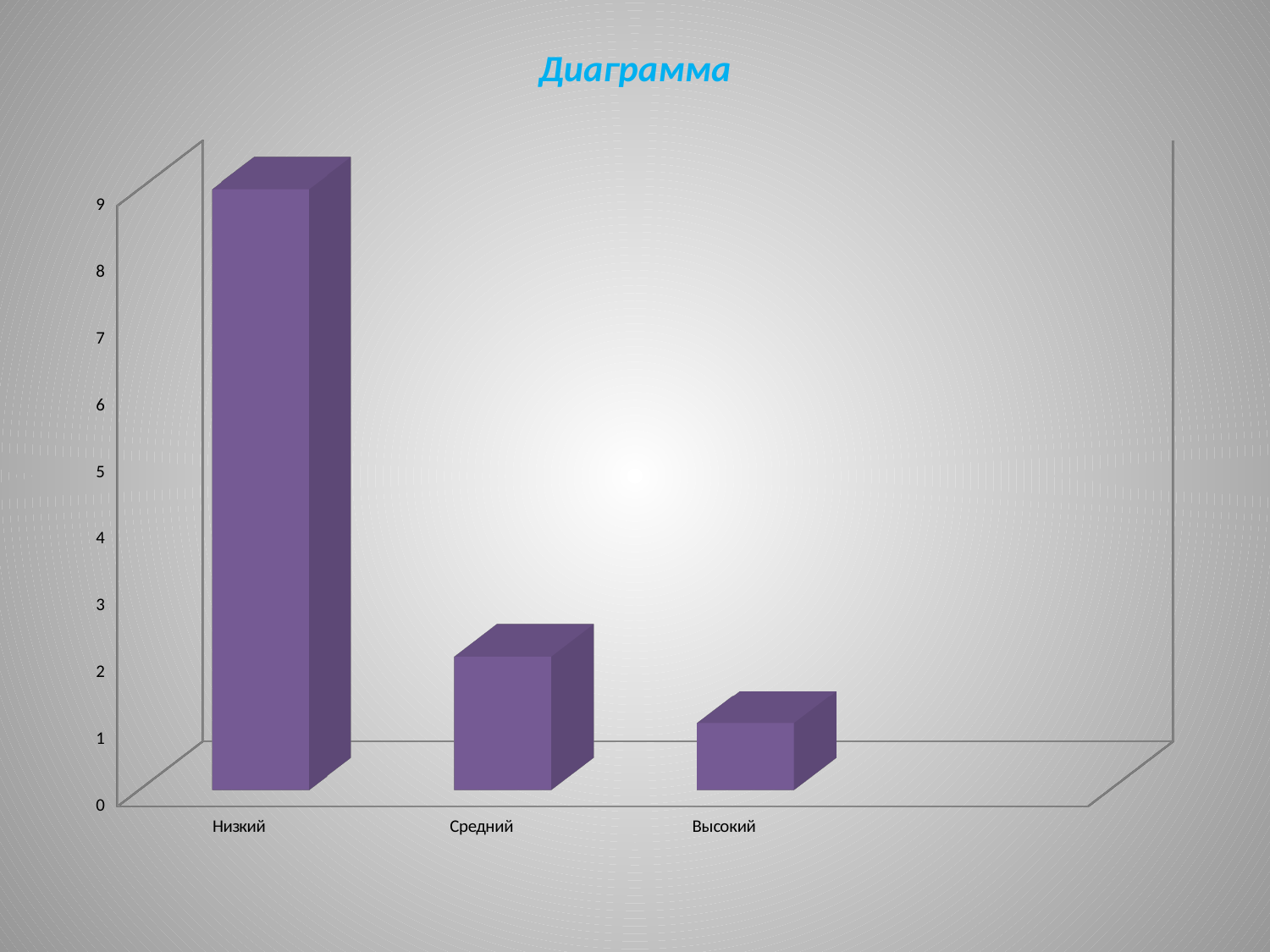
Which is larger, the value for Низкий or the value for Средний? Низкий How many categories are shown on the x axis of the chart? 3 Is the value for Высокий greater or less than 3? less Is the value for Низкий greater or less than 5? greater Which category has the lowest bar? Высокий Is the value for Средний greater or less than 5? less Do the bar values rise or fall from Низкий to Высокий along the x axis? fall Which is larger, the value for Средний or the value for Высокий? Средний What is the title of the chart? Диаграмма What kind of chart is shown on the slide? bar chart Which category has the highest bar? Низкий What colour are the bars in the chart? purple